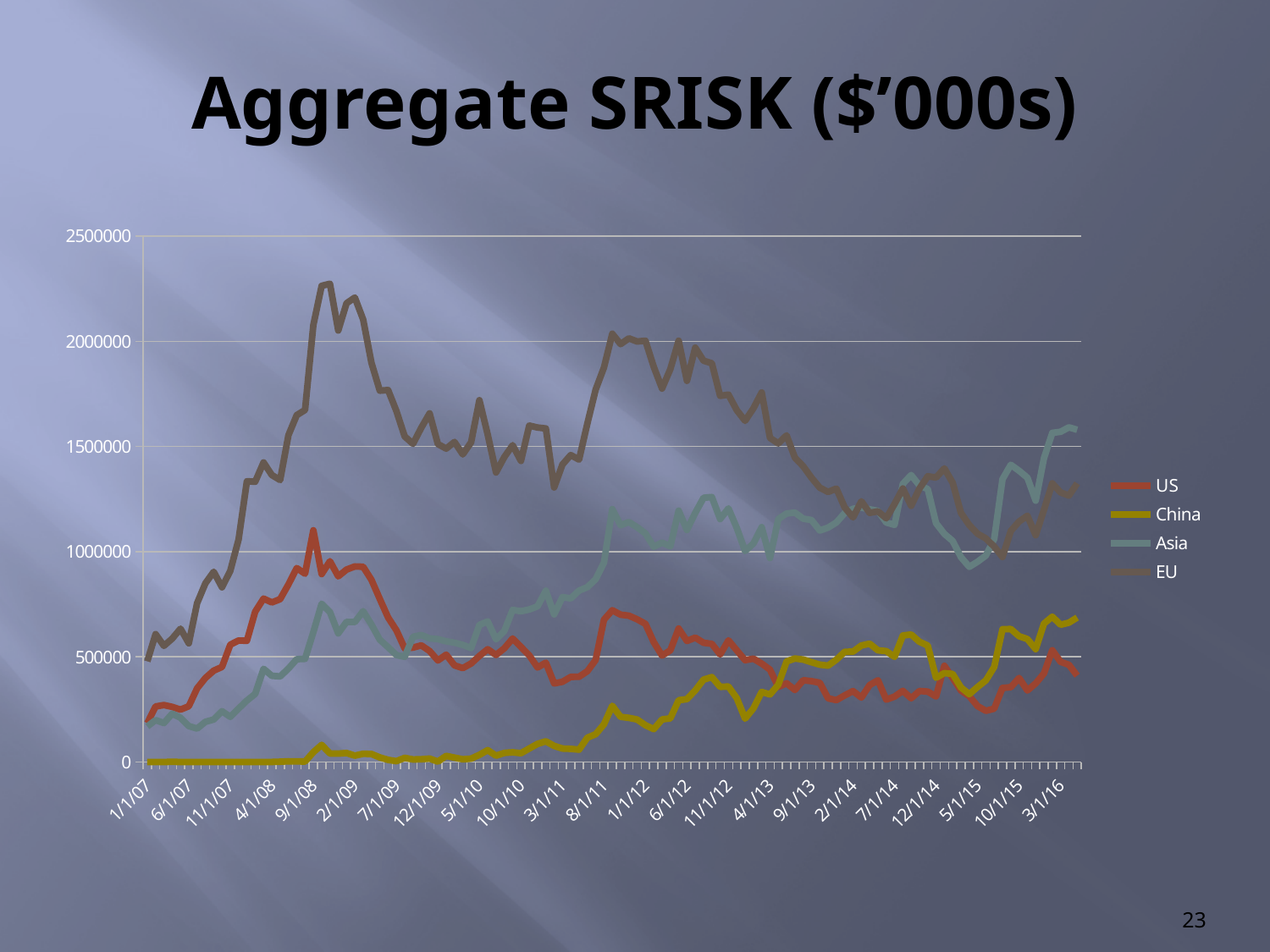
What is the title of the chart? Aggregate SRISK ($'000s) Which series reaches the highest value anywhere on the chart? EU Is the peak value of the EU series around 9/1/08 greater or less than 2000000? greater Which series is shown in red? US Which series has the lowest value at 1/1/07? China Is the value for Asia at 3/1/16 greater or less than 1500000? greater At 3/1/16, which is larger, the Asia series or the US series? Asia Is the value for EU at 1/1/07 greater or less than 1000000? less How many series does the legend list? 4 Does the China series rise or fall overall from 1/1/07 to 3/1/16? rise What kind of chart is shown on the slide? line chart